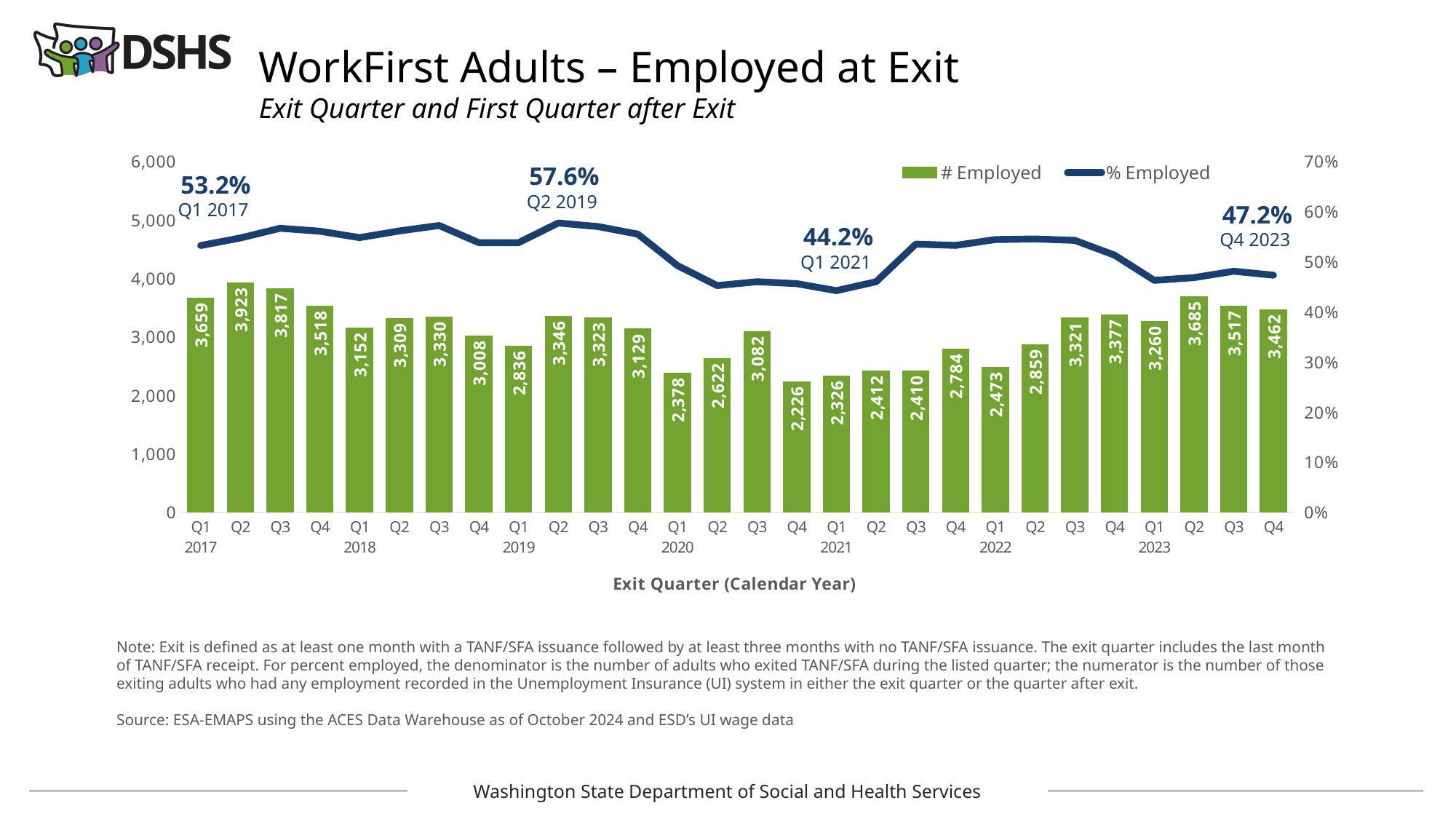
Which has a larger # Employed, Q3 2022 or Q1 2023? Q3 2022 What kind of chart is this? Combination bar and line chart What is the difference in # Employed between Q2 2017 and Q4 2020? 1,697 How many series does the legend list? 2 Is the % Employed value for Q4 2020 greater or less than 50%? less What is the % Employed value labelled for Q4 2023? 47.2% Which quarter has the highest # Employed? Q2 2017 How many quarters are shown on the x axis? 28 Does # Employed rise or fall from Q1 2017 to Q1 2018? fall What is the % Employed value labelled for Q1 2021? 44.2% Which quarter has the lowest # Employed? Q4 2020 What is the # Employed value for Q2 2019? 3,346